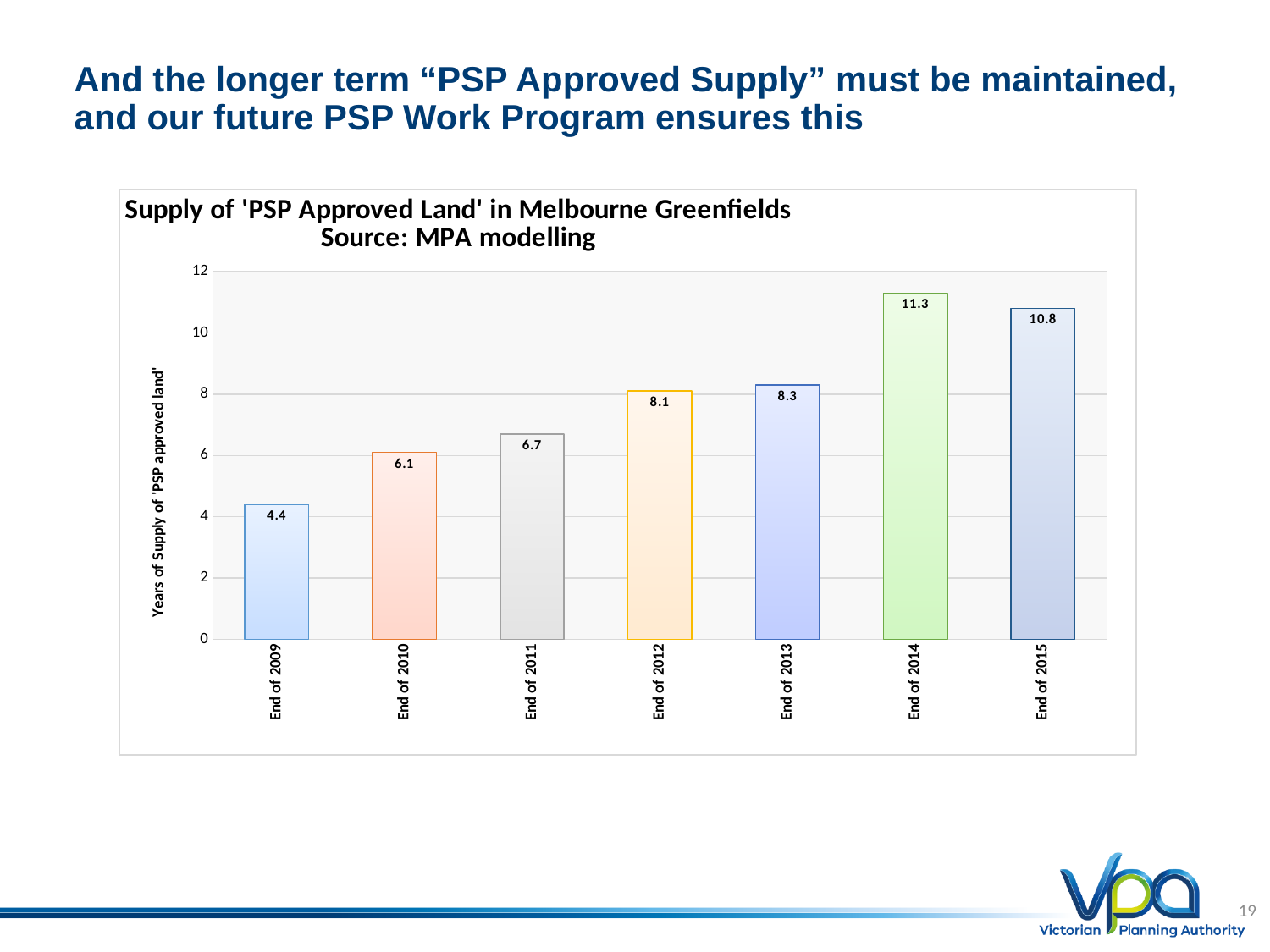
Do the values generally rise or fall from End of 2009 to End of 2014? rise Which year has the highest years of supply? End of 2014 What kind of chart is shown on the slide? bar chart What is the value for End of 2015? 10.8 Which is larger, the value for End of 2011 or End of 2012? End of 2012 What is the value for End of 2009? 4.4 What is the difference between the values for End of 2014 and End of 2009? 6.9 Which year has the lowest years of supply? End of 2009 What is the label of the vertical axis? Years of Supply of 'PSP approved land' Is the value for End of 2010 greater or less than 8? less What is the value for End of 2013? 8.3 How many bars are shown in the chart? 7